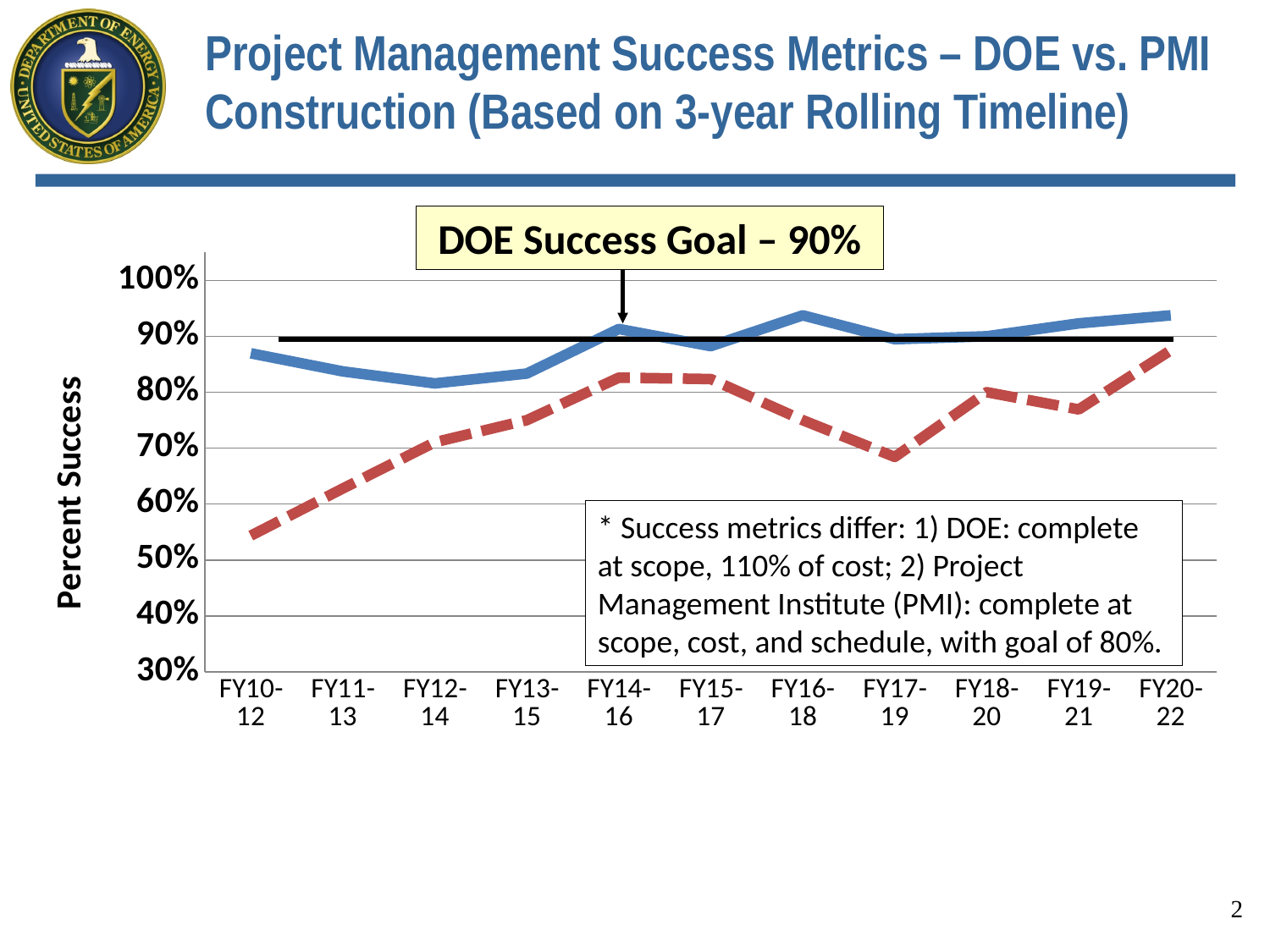
What is the title of the vertical axis? Percent Success At FY10-12, which line has the higher value, the solid blue line or the red dashed line? solid blue line In which period does the red dashed line reach its highest value? FY20-22 What is the DOE Success Goal shown on the chart? 90% Is the value of the red dashed line at FY10-12 greater or less than 60%? less How many fiscal-year periods are shown along the x axis? 11 Is the value of the solid blue line at FY12-14 greater or less than 90%? less Is the value of the red dashed line at FY17-19 greater or less than 80%? less What kind of chart is shown on the slide? line chart In which period does the red dashed line have its lowest value? FY10-12